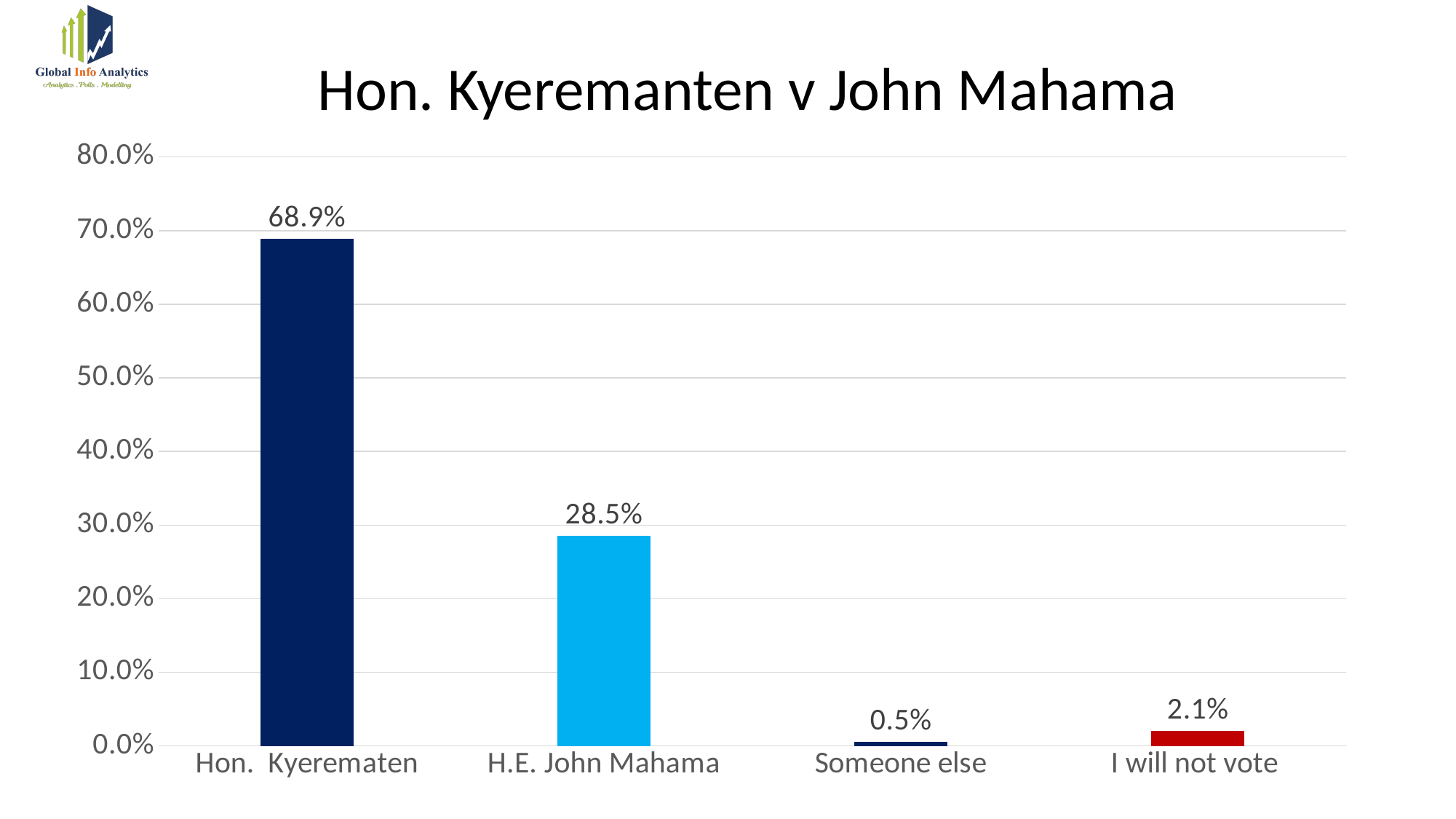
What is the difference between the values for Hon. Kyeremanten and H.E. John Mahama? 40.4% What is the value for Hon. Kyeremanten? 68.9% Is the value for H.E. John Mahama greater or less than 30.0%? less Which category has the highest value? Hon. Kyerematen What is the value for I will not vote? 2.1% How many categories are shown on the chart? 4 What is the title of the chart? Hon. Kyeremanten v John Mahama Which category has the lowest value? Someone else Which is larger, the value for I will not vote or the value for Someone else? I will not vote What is the value for Someone else? 0.5% What is the value for H.E. John Mahama? 28.5% What kind of chart is shown on the slide? bar chart